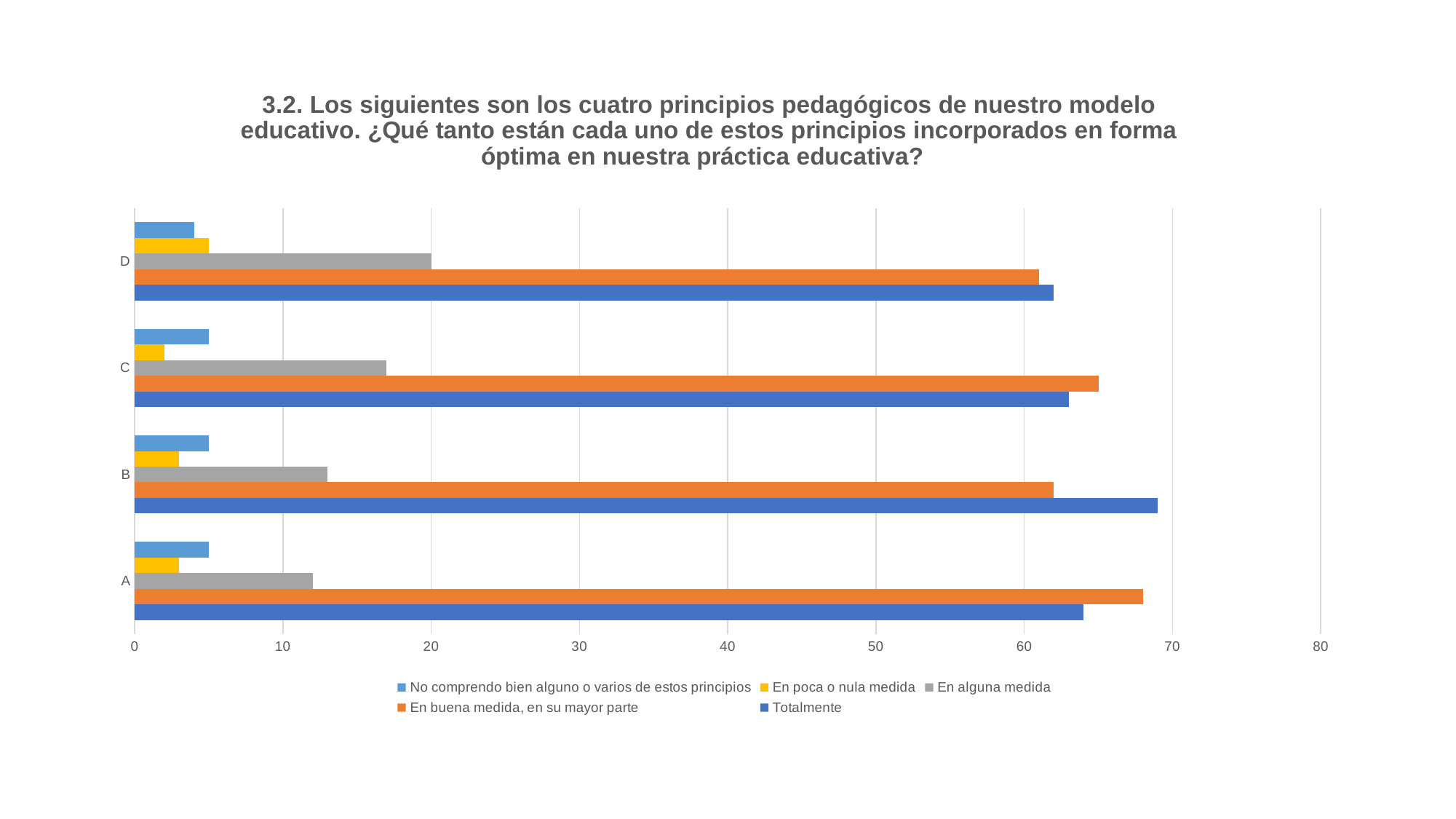
Which category has the highest value for "En alguna medida"? D Which category has the highest value for "Totalmente"? B Is the value of "En poca o nula medida" for category C greater or less than 10? less Is the value of "Totalmente" for category B greater or less than 60? greater How many series does the legend list? 5 For category B, which is larger: "En alguna medida" or "En poca o nula medida"? En alguna medida For category A, which is larger: "En buena medida, en su mayor parte" or "Totalmente"? En buena medida, en su mayor parte Is the value of "En alguna medida" for category A greater or less than 20? less What colour represents the "Totalmente" series in the chart? blue What kind of chart is shown on the slide? bar chart How many categories are shown on the vertical axis of the chart? 4